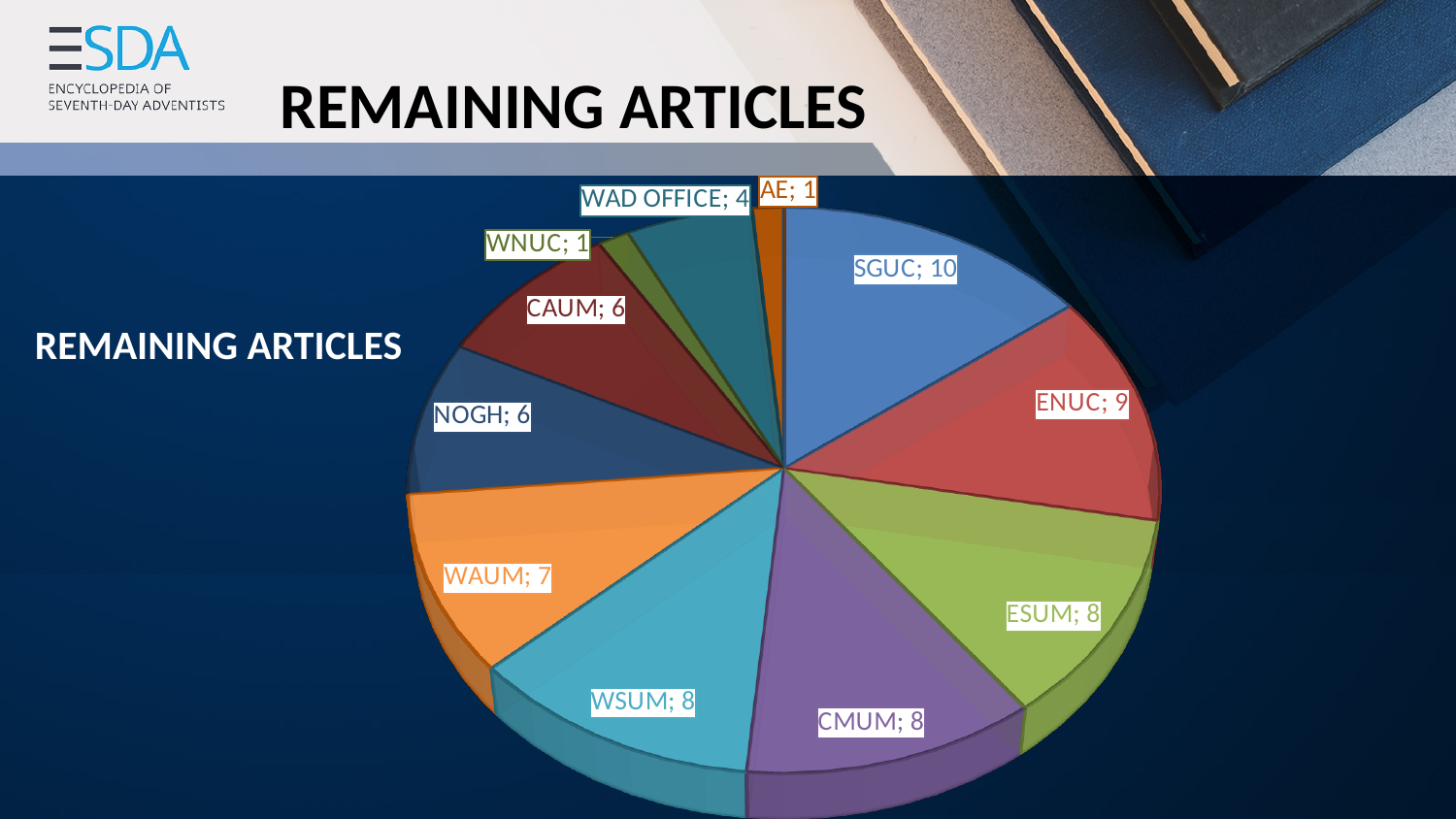
Which has the larger value, WAUM or NOGH? WAUM What is the difference between the values for SGUC and ENUC? 1 What is the value for WAUM in the pie chart? 7 What is the title of the chart on the slide? REMAINING ARTICLES How many categories (slices) are shown in the pie chart? 11 What is the value for WAD OFFICE in the pie chart? 4 Which has the larger value, ENUC or ESUM? ENUC What is the difference between the values for ESUM and WAD OFFICE? 4 What is the value for SGUC in the pie chart? 10 What kind of chart is shown on the slide? Pie chart What is the value for CAUM in the pie chart? 6 Which category has the highest value in the pie chart? SGUC